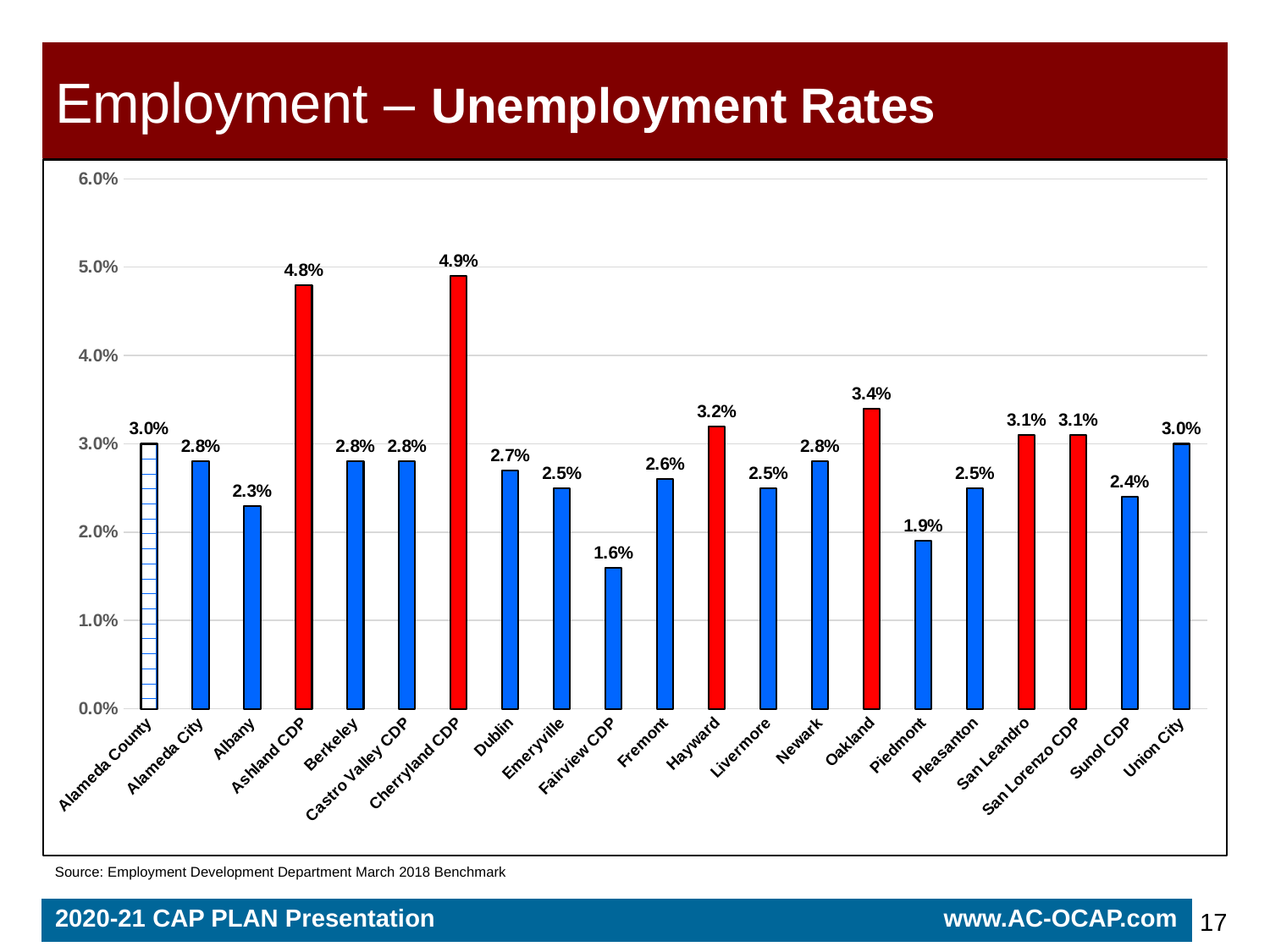
What is the unemployment rate shown for Alameda County? 3.0% How many categories are shown on the x axis of the chart? 21 Which category has the lowest unemployment rate? Fairview CDP What is the unemployment rate shown for Piedmont? 1.9% Is the value for Sunol CDP greater or less than 3.0%? less What is the difference between the unemployment rates of Union City and Fairview CDP? 1.4% What kind of chart is shown on the slide? Bar chart What is the difference between the unemployment rates of Ashland CDP and Albany? 2.5% Which has a higher unemployment rate, Oakland or Hayward? Oakland Which category has the highest unemployment rate? Cherryland CDP What is the unemployment rate shown for Cherryland CDP? 4.9% How many bars in the chart are coloured red? 6